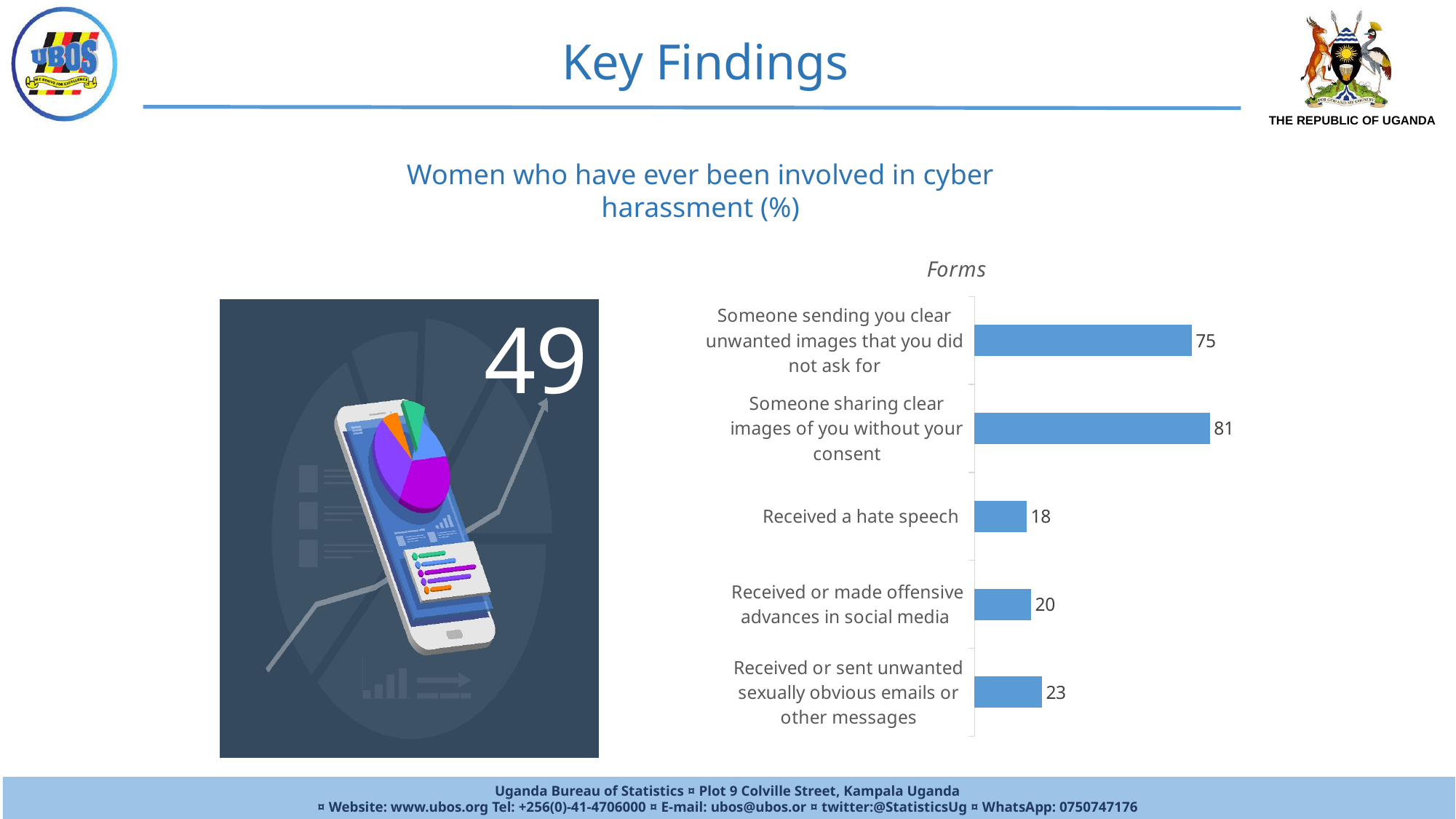
What is the value for "Received or sent unwanted sexually obvious emails or other messages" in the Forms chart? 23 Which form of cyber harassment has the highest value in the Forms chart? Someone sharing clear images of you without your consent What is the title of the chart on the slide? Forms Which form of cyber harassment has the lowest value in the Forms chart? Received a hate speech What is the value for "Someone sharing clear images of you without your consent" in the Forms chart? 81 In the Forms chart, which is larger: "Received or sent unwanted sexually obvious emails or other messages" or "Received or made offensive advances in social media"? Received or sent unwanted sexually obvious emails or other messages What is the value for "Received or made offensive advances in social media" in the Forms chart? 20 What is the difference between the values for "Someone sharing clear images of you without your consent" and "Someone sending you clear unwanted images that you did not ask for" in the Forms chart? 6 How many categories are shown in the Forms chart? 5 What is the difference between the values for "Received or sent unwanted sexually obvious emails or other messages" and "Received a hate speech" in the Forms chart? 5 What kind of chart is the Forms chart? Bar chart What is the value for "Received a hate speech" in the Forms chart? 18